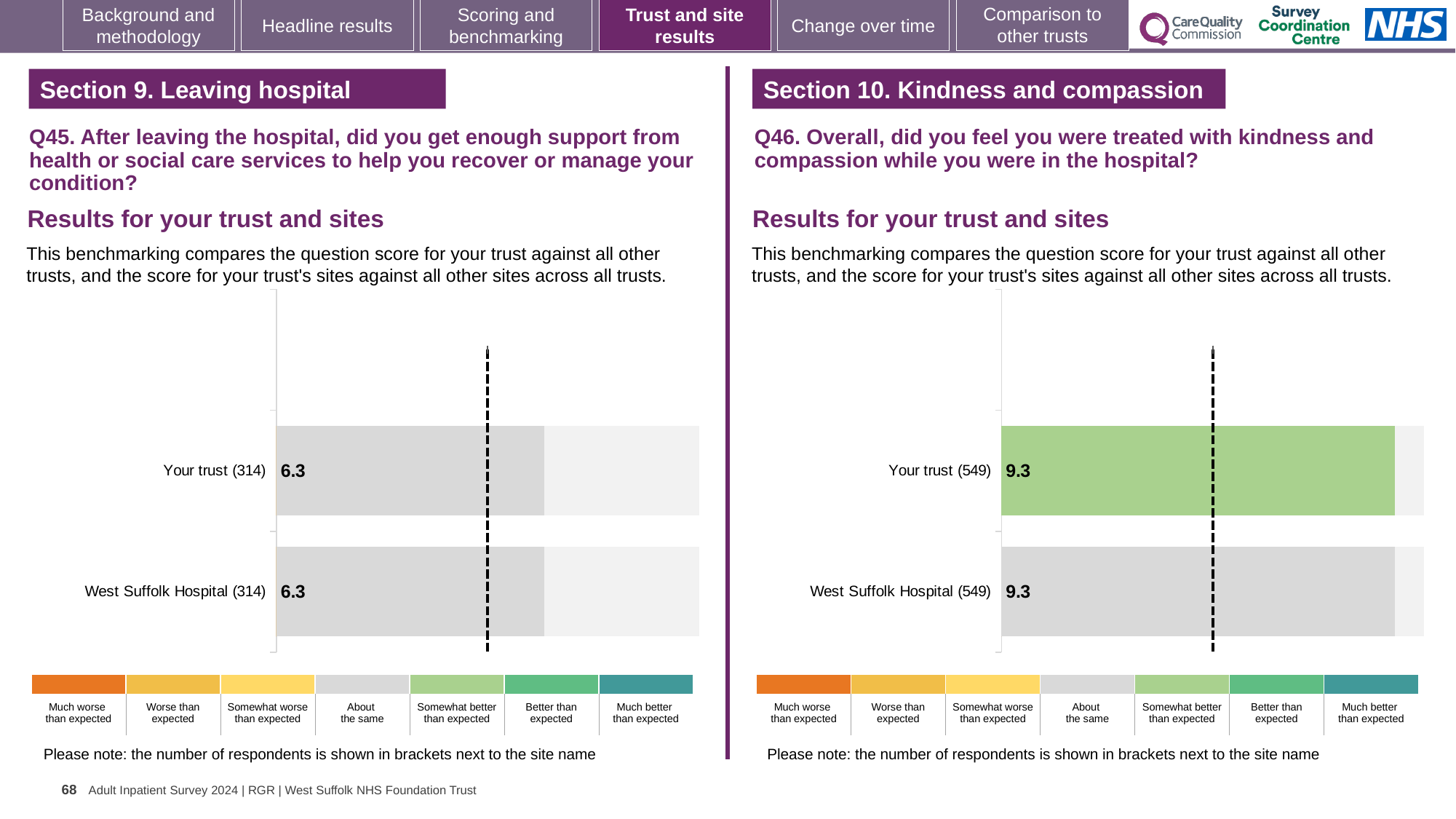
How many bars are plotted on the Q46 chart (right)? 2 On the Q45 chart (left), what is the score for West Suffolk Hospital? 6.3 How many benchmark categories does the colour key below the Q45 chart (left) list? 7 How many bars are plotted on the Q45 chart (left)? 2 On the Q46 chart (right), what is the score for West Suffolk Hospital? 9.3 On the Q46 chart (right), how many respondents are shown in brackets for Your trust? 549 On the Q46 chart (right), what is the score for Your trust? 9.3 On the Q46 chart (right), what is the difference between the Your trust score and the West Suffolk Hospital score? 0 On the Q45 chart (left), what is the score for Your trust? 6.3 On the Q45 chart (left), what is the difference between the Your trust score and the West Suffolk Hospital score? 0 What kind of chart is used on the Q46 chart (right)? Bar chart On the Q45 chart (left), how many respondents are shown in brackets for West Suffolk Hospital? 314